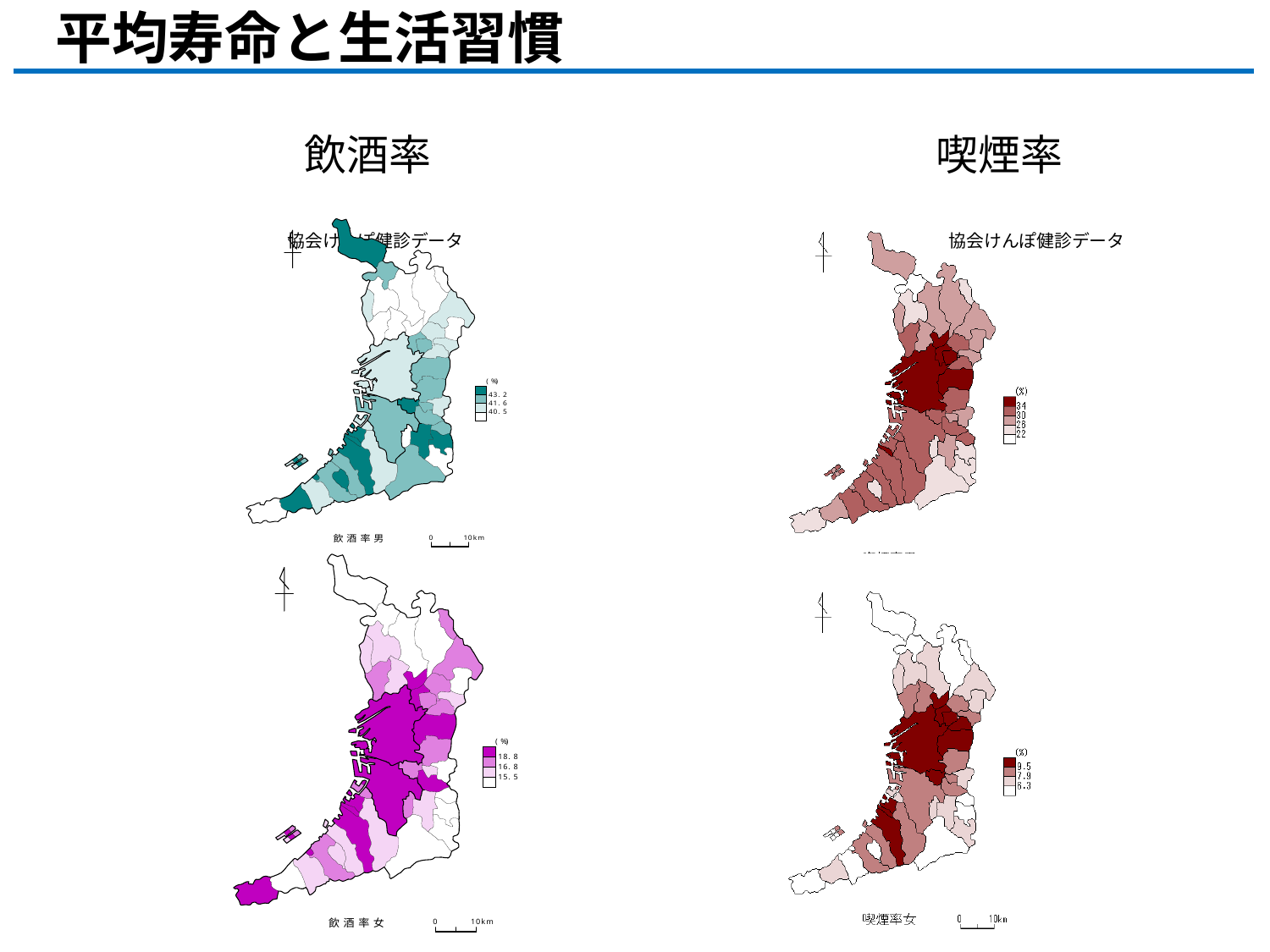
What is the title of the slide? 平均寿命と生活習慣 What is the lowest legend value on the male drinking rate (飲酒率男) map? 40.5 How many legend classes does the male smoking rate map (top right) show? 4 What is the lowest legend value on the female drinking rate (飲酒率女) map? 15.5 What is the highest legend value on the female smoking rate (喫煙率女) map? 9.5 How many maps are shown on the slide? 4 What kind of chart is used on this slide to show drinking and smoking rates? Choropleth map What data source is cited above the maps? 協会けんぽ健診データ What is the highest legend value on the male drinking rate (飲酒率男) map? 43.2 What is the highest legend value on the male smoking rate map (top right)? 34 What is the highest legend value on the female drinking rate (飲酒率女) map? 18.8